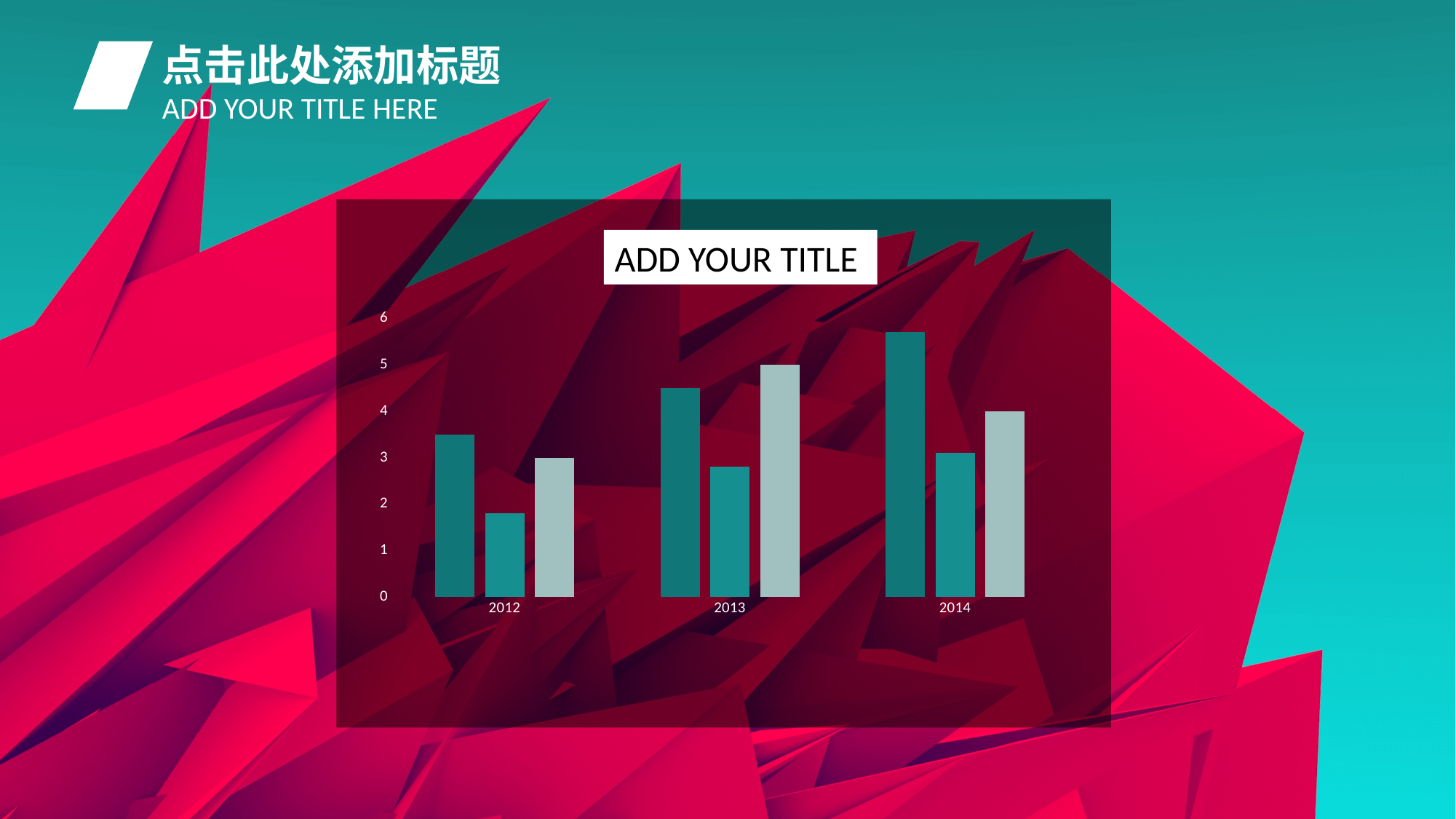
Is the value of the tallest (dark teal, leftmost) bar for 2012 greater or less than 3? greater Is the value of the leftmost bar for 2013 greater or less than 4? greater Which year contains the shortest bar on the chart? 2012 What is the highest value shown on the chart's vertical axis? 6 Is the value of the leftmost bar for 2014 greater or less than 5? greater What is the title shown above the chart? ADD YOUR TITLE How many categories are shown on the x axis of the chart? 3 Do the leftmost (dark teal) bars rise or fall from 2012 to 2014? rise Which year has the tallest bar on the chart? 2014 What kind of chart is shown on the slide? bar chart